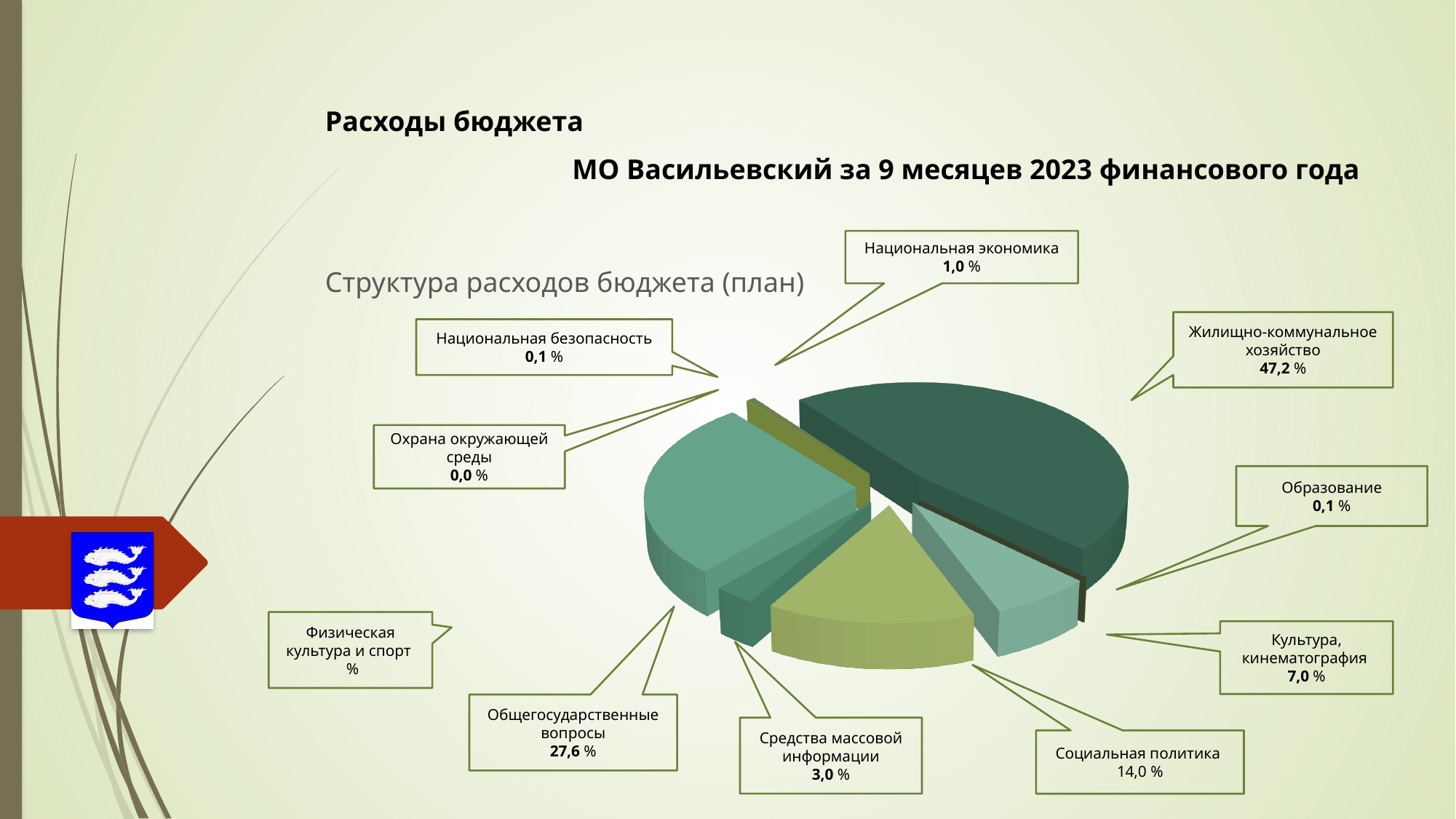
What share of the pie is Культура, кинематография? 7,0 % What share of the pie is Общегосударственные вопросы? 27,6 % What is the title of the chart? Структура расходов бюджета (план) What kind of chart is shown on the slide? pie chart What share of the pie is Социальная политика? 14,0 % What share of the pie is Средства массовой информации? 3,0 % What share of the pie is Национальная экономика? 1,0 % What is the difference between the shares of Жилищно-коммунальное хозяйство and Общегосударственные вопросы? 19,6 % What share of the pie is Жилищно-коммунальное хозяйство? 47,2 % Which is larger, the share of Социальная политика or the share of Культура, кинематография? Социальная политика Which category has the largest share of the pie? Жилищно-коммунальное хозяйство